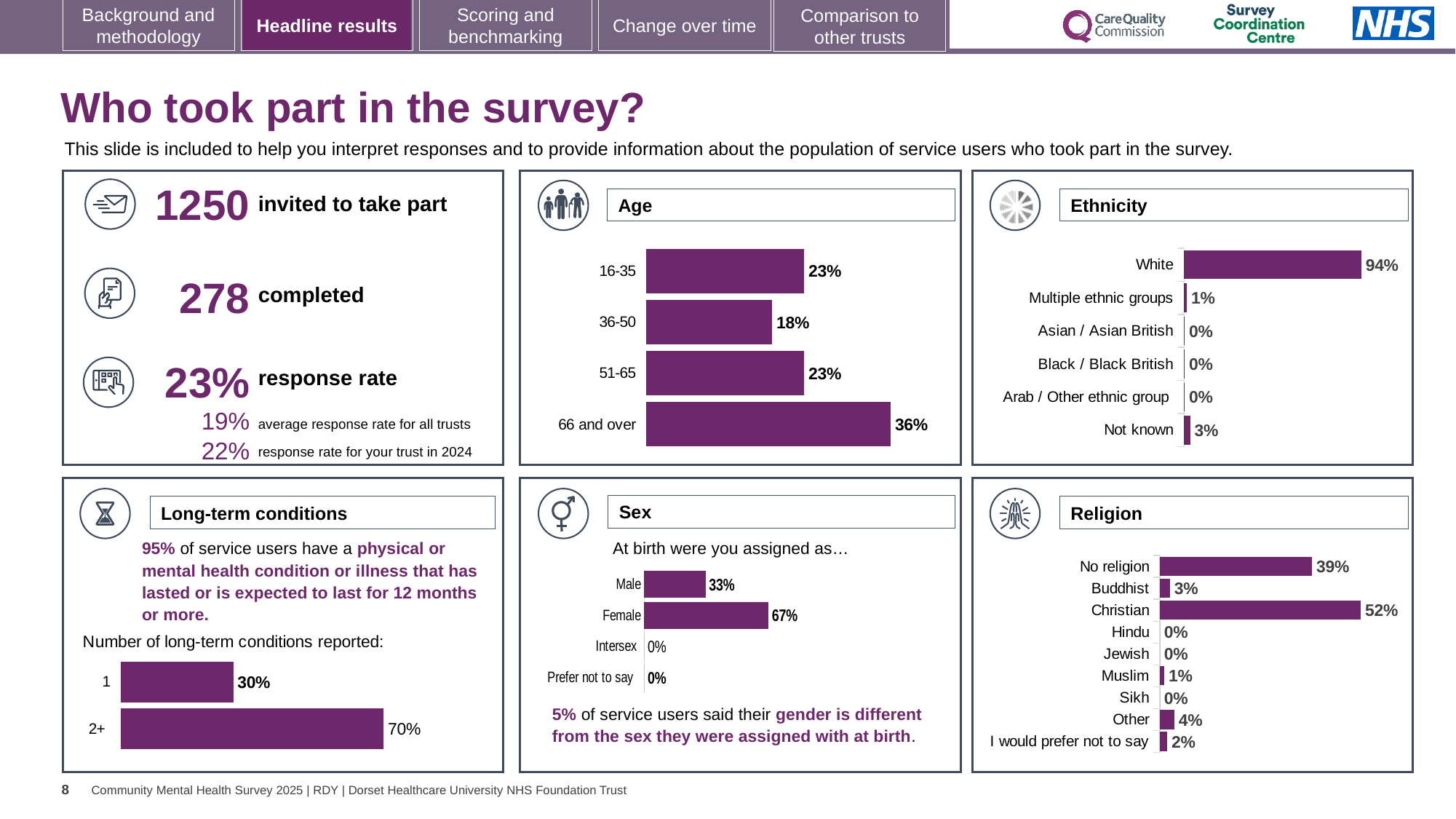
In the Long-term conditions chart, what percentage of service users reported 2+ long-term conditions? 70% In the Age chart, which age group has the lowest percentage? 36-50 In the Ethnicity chart, how many ethnicity categories are shown? 6 In the Religion chart, what is the difference between Christian and No religion? 13% In the Age chart, what percentage of respondents were aged 66 and over? 36% In the Age chart, what is the difference between the 66 and over group and the 36-50 group? 18% In the Sex chart, which is larger, Male or Female? Female In the Age chart, which age group has the highest percentage? 66 and over In the Ethnicity chart, what percentage of respondents were White? 94% In the Sex chart, what percentage of respondents were assigned Female at birth? 67% In the Ethnicity chart, what percentage is shown for Not known? 3% In the Religion chart, which religion category has the highest percentage? Christian